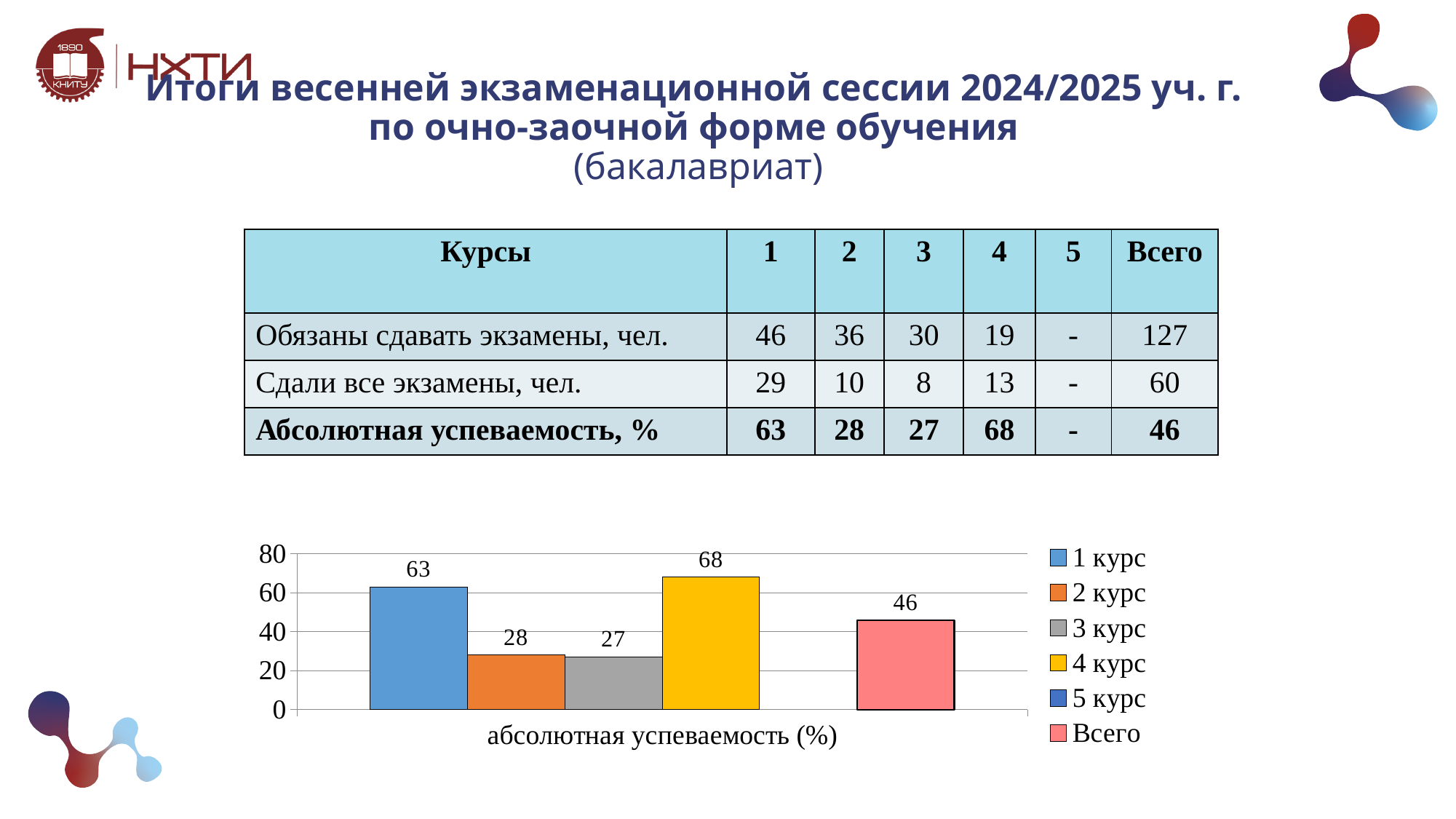
What is the value for 4 курс in the chart? 68 Which series has the lowest plotted value in the chart? 3 курс What is the difference between the values for 1 курс and Всего? 17 What is the value for 2 курс in the chart? 28 Which series has the highest value in the chart? 4 курс What type of chart is shown on the slide? bar chart What is the value for 1 курс in the chart? 63 What is the value for Всего in the chart? 46 What is the difference between the values for 4 курс and 1 курс? 5 Which is larger, the value for 1 курс or the value for Всего? 1 курс What is the label shown on the x axis of the chart? абсолютная успеваемость (%) How many series does the chart legend list? 6